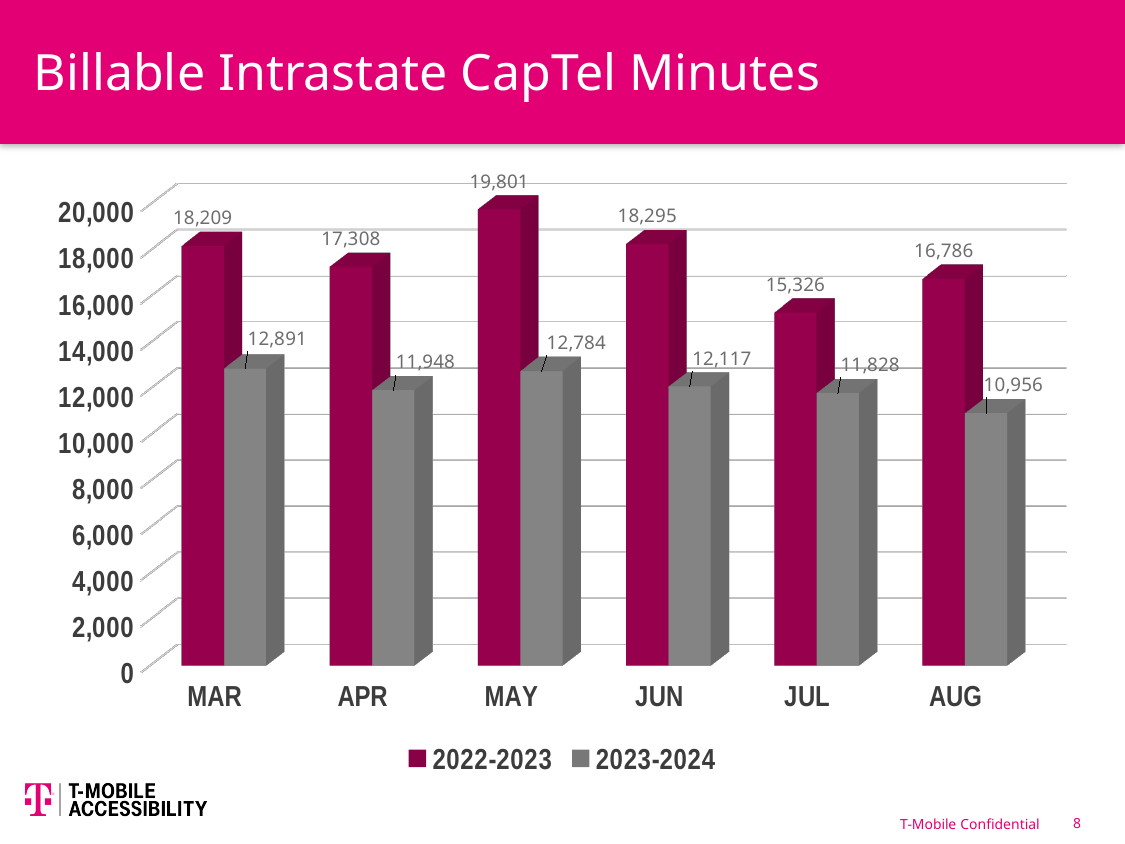
Which month has the highest value in the 2022-2023 series? MAY What is the value for AUG in the 2023-2024 series? 10,956 What is the title of the chart? Billable Intrastate CapTel Minutes Which month has the lowest value in the 2023-2024 series? AUG How many months are shown on the x axis? 6 What is the value for MAY in the 2022-2023 series? 19,801 Which is larger: the 2023-2024 value for JUN or the 2023-2024 value for JUL? JUN What is the value for APR in the 2023-2024 series? 11,948 Is the 2022-2023 value for JUL greater or less than 16,000? less What is the difference between the 2022-2023 and 2023-2024 values for MAR? 5,318 How many series does the legend list? 2 What kind of chart is shown on the slide? bar chart